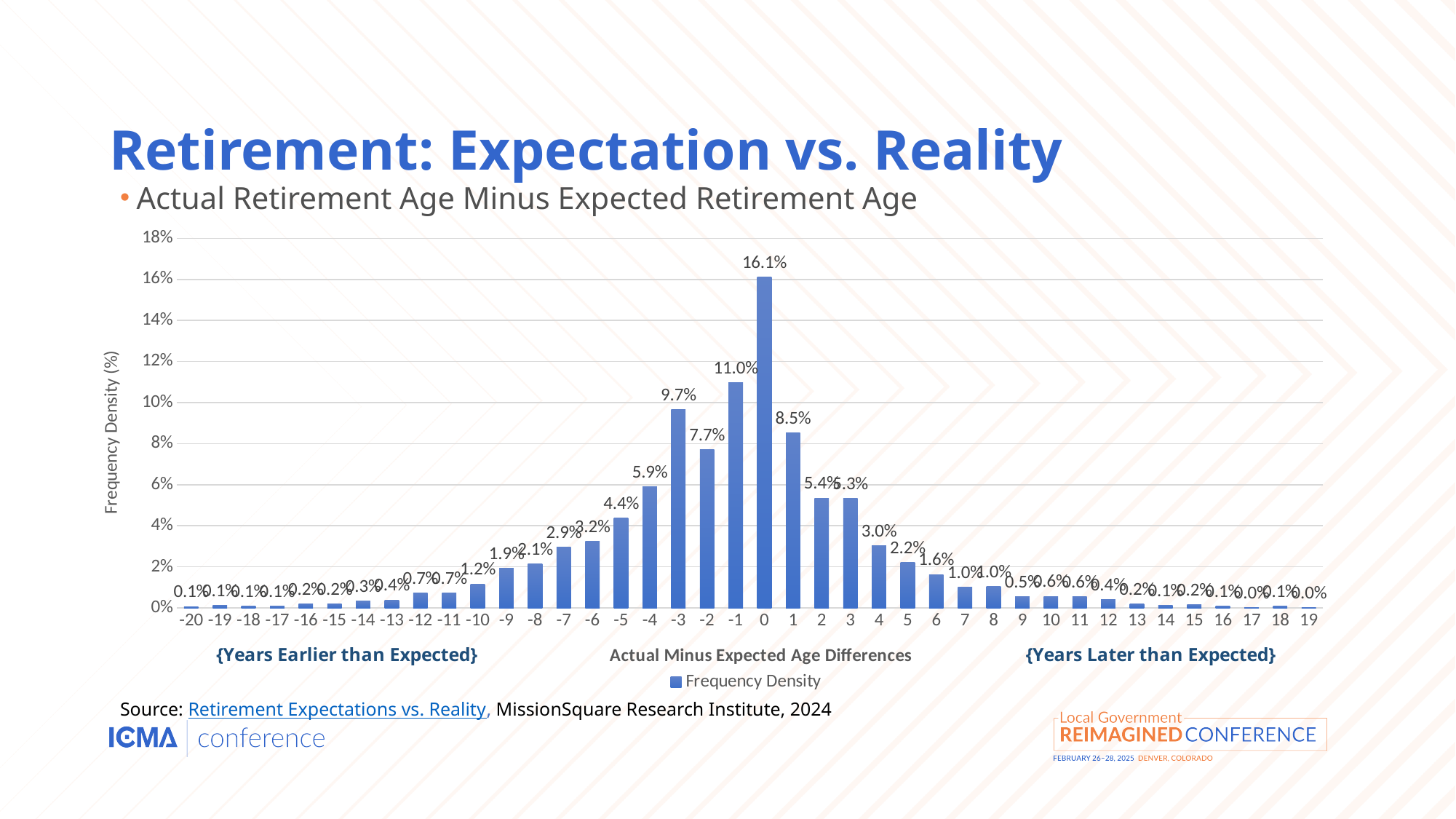
What is the frequency density for an age difference of 0? 16.1% What kind of chart is shown on the slide? Bar chart How many series does the legend list? 1 What is the frequency density for an age difference of -3? 9.7% What is the frequency density for an age difference of 1? 8.5% What is the frequency density for an age difference of 4? 3.0% Which has a higher frequency density, age difference -3 or age difference -2? -3 What is the difference in frequency density between age difference 0 and age difference -1? 5.1 percentage points Do the frequency density values generally rise or fall as the age difference goes from -20 to 0? Rise Which age difference has the highest frequency density? 0 Is the frequency density for age difference -1 greater or less than 10%? greater How many age-difference categories are shown on the x axis? 40